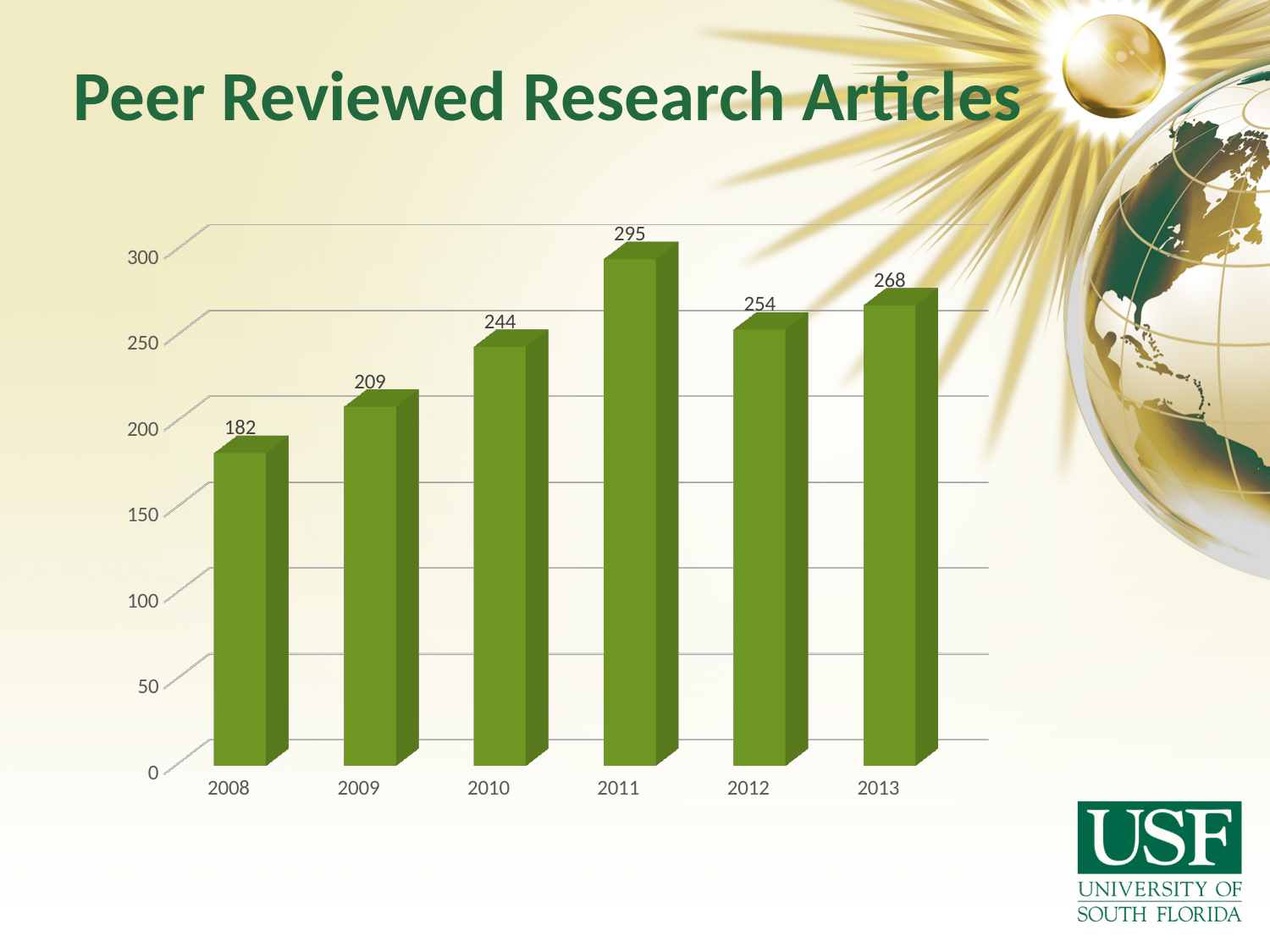
Which year has the lowest value? 2008 How many years are shown on the x axis? 6 What is the value for 2013? 268 What is the title of the slide? Peer Reviewed Research Articles What is the difference between the values for 2010 and 2009? 35 What is the value for 2011? 295 Is the value for 2010 greater or less than 200? greater What is the difference between the values for 2011 and 2012? 41 What is the value for 2008? 182 Which is larger, the value for 2012 or the value for 2013? 2013 Which year has the highest value? 2011 What kind of chart is shown on the slide? Bar chart